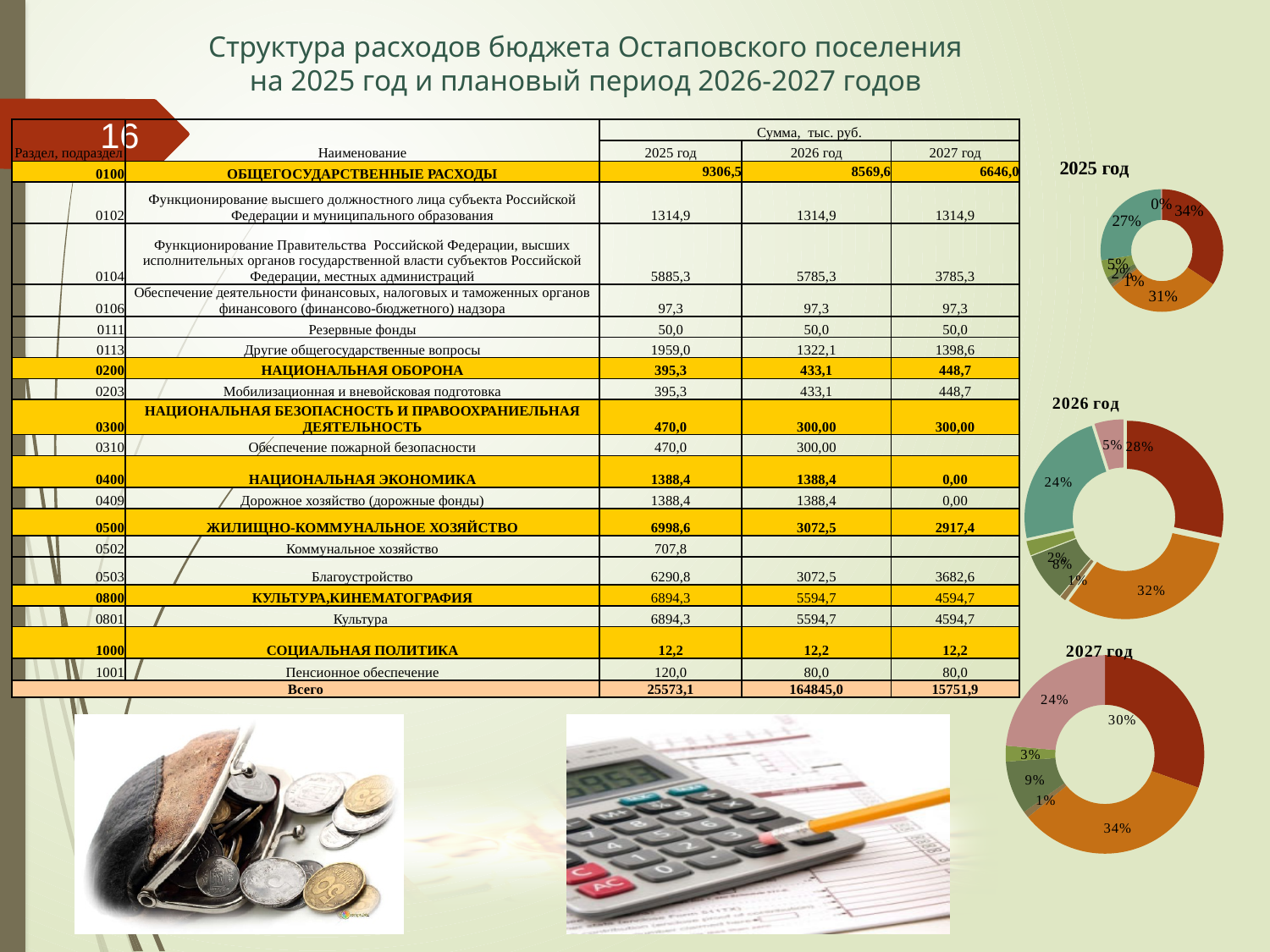
How many charts are shown on the slide? 3 What kind of chart is used for the "2025 год" chart? Doughnut chart In the "2027 год" chart, which is larger: the pink slice or the orange slice? The orange slice In the "2026 год" chart, what is the percentage of the largest slice? 32% What are the titles of the three charts on the slide? 2025 год, 2026 год, 2027 год In the "2027 год" chart, what is the difference in percentage points between the 34% slice and the 30% slice? 4 In the "2027 год" chart, what is the percentage of the smallest labelled slice? 1% Do the charts on the slide include a legend? No In the "2026 год" chart, what is the percentage of the smallest labelled slice? 1% In the "2027 год" chart, how many slices are labelled? 6 In the "2025 год" chart, what is the percentage of the largest slice? 34% In the "2027 год" chart, what is the percentage of the largest slice? 34%